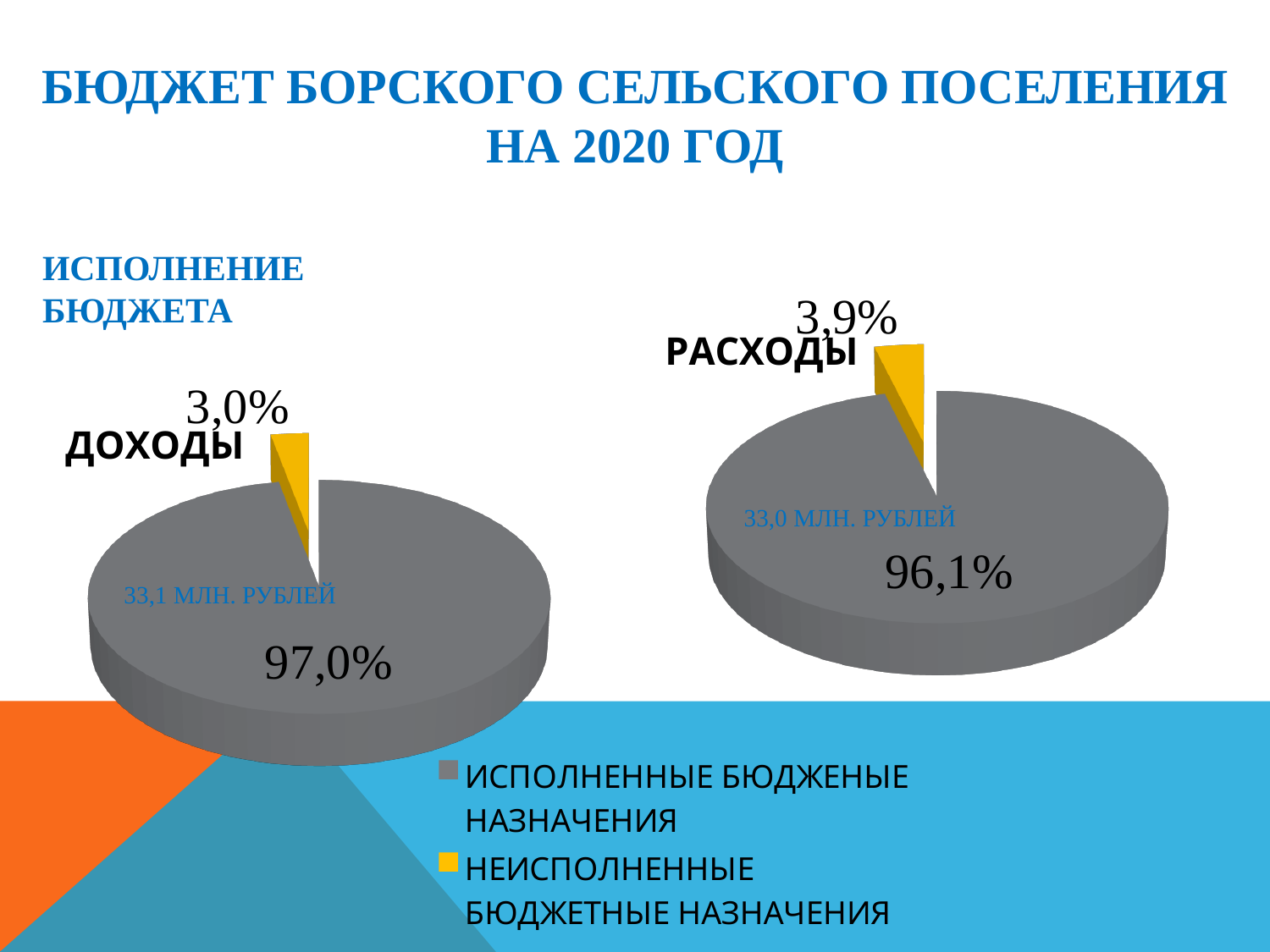
What kind of chart is the ДОХОДЫ chart? Pie chart What colour represents the unexecuted budget appropriations in the legend? Yellow What amount in million rubles is written on the ДОХОДЫ chart? 33,1 МЛН. РУБЛЕЙ Which slice is larger in the ДОХОДЫ chart: executed or unexecuted budget appropriations? Executed budget appropriations What is the difference between the unexecuted shares in the РАСХОДЫ and ДОХОДЫ charts? 0,9% How many entries does the legend list? 2 How many slices does the РАСХОДЫ pie chart have? 2 Which chart has the larger unexecuted share: ДОХОДЫ or РАСХОДЫ? РАСХОДЫ In the РАСХОДЫ chart, what share is labelled for the unexecuted budget appropriations (yellow slice)? 3,9% In the ДОХОДЫ chart, what share is labelled for the unexecuted budget appropriations (yellow slice)? 3,0% In the ДОХОДЫ chart, what share is labelled for the executed budget appropriations (grey slice)? 97,0% In the РАСХОДЫ chart, what share is labelled for the executed budget appropriations (grey slice)? 96,1%